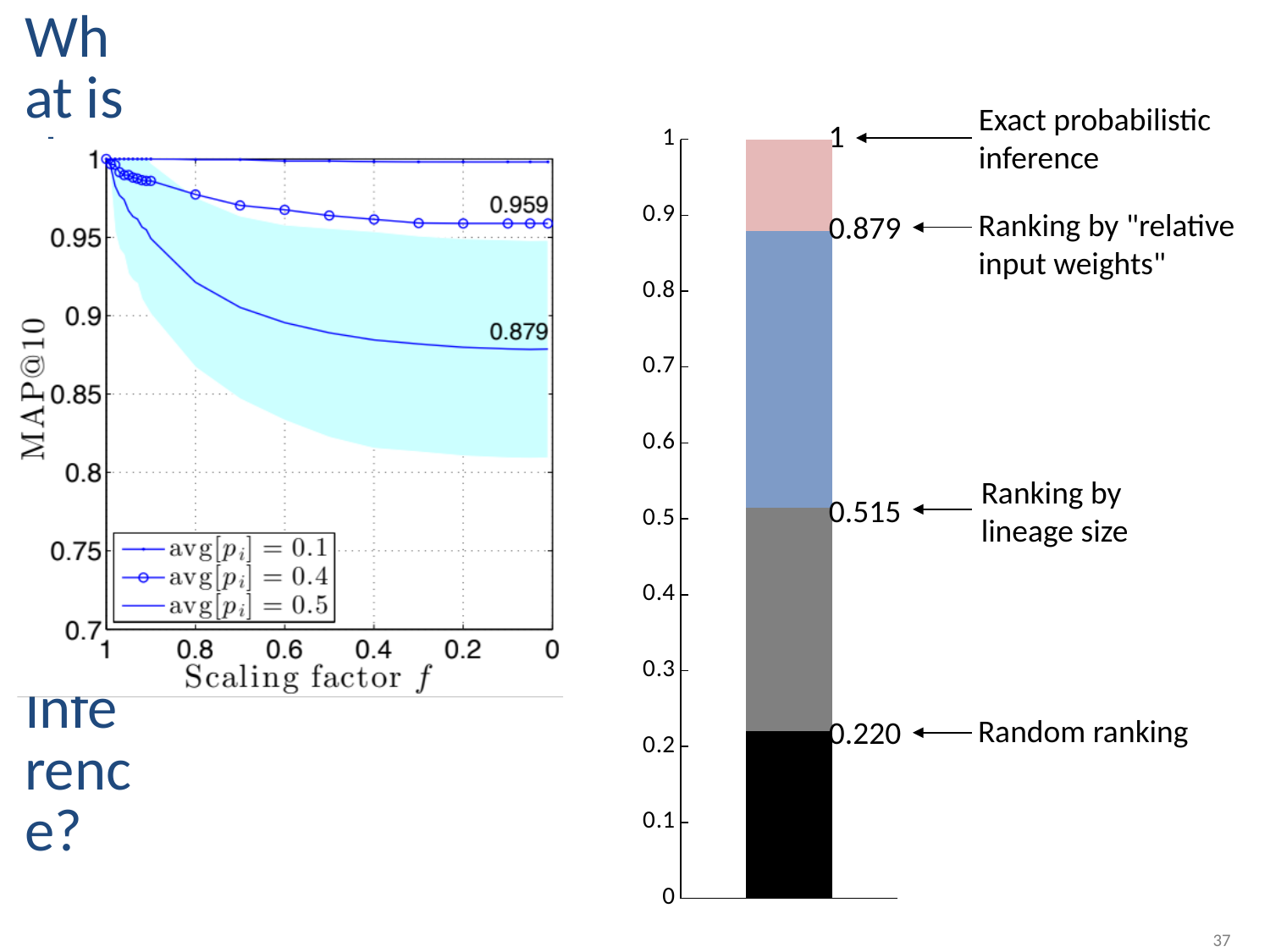
In the right chart, what value is labelled for Ranking by "relative input weights"? 0.879 In the left chart, what is the labelled MAP@10 value reached by the avg[p_i] = 0.5 series at scaling factor f = 0? 0.879 In the left chart, how many series does the legend list? 3 In the right chart, how many coloured segments make up the stacked bar? 4 In the left chart, which series ends with the lower MAP@10 at f = 0: avg[p_i] = 0.4 or avg[p_i] = 0.5? avg[p_i] = 0.5 In the left chart, what is the label of the y axis? MAP@10 What kind of chart is the chart on the left of the slide? line chart In the right chart, what value is labelled for Random ranking? 0.220 In the right chart, what is the difference between the labelled values for Ranking by "relative input weights" and Ranking by lineage size? 0.364 In the right chart, what value is labelled for Ranking by lineage size? 0.515 In the left chart, what is the labelled MAP@10 value reached by the avg[p_i] = 0.4 series at scaling factor f = 0? 0.959 In the left chart, does the MAP@10 of the avg[p_i] = 0.5 series rise or fall as the scaling factor f decreases from 1 to 0? fall